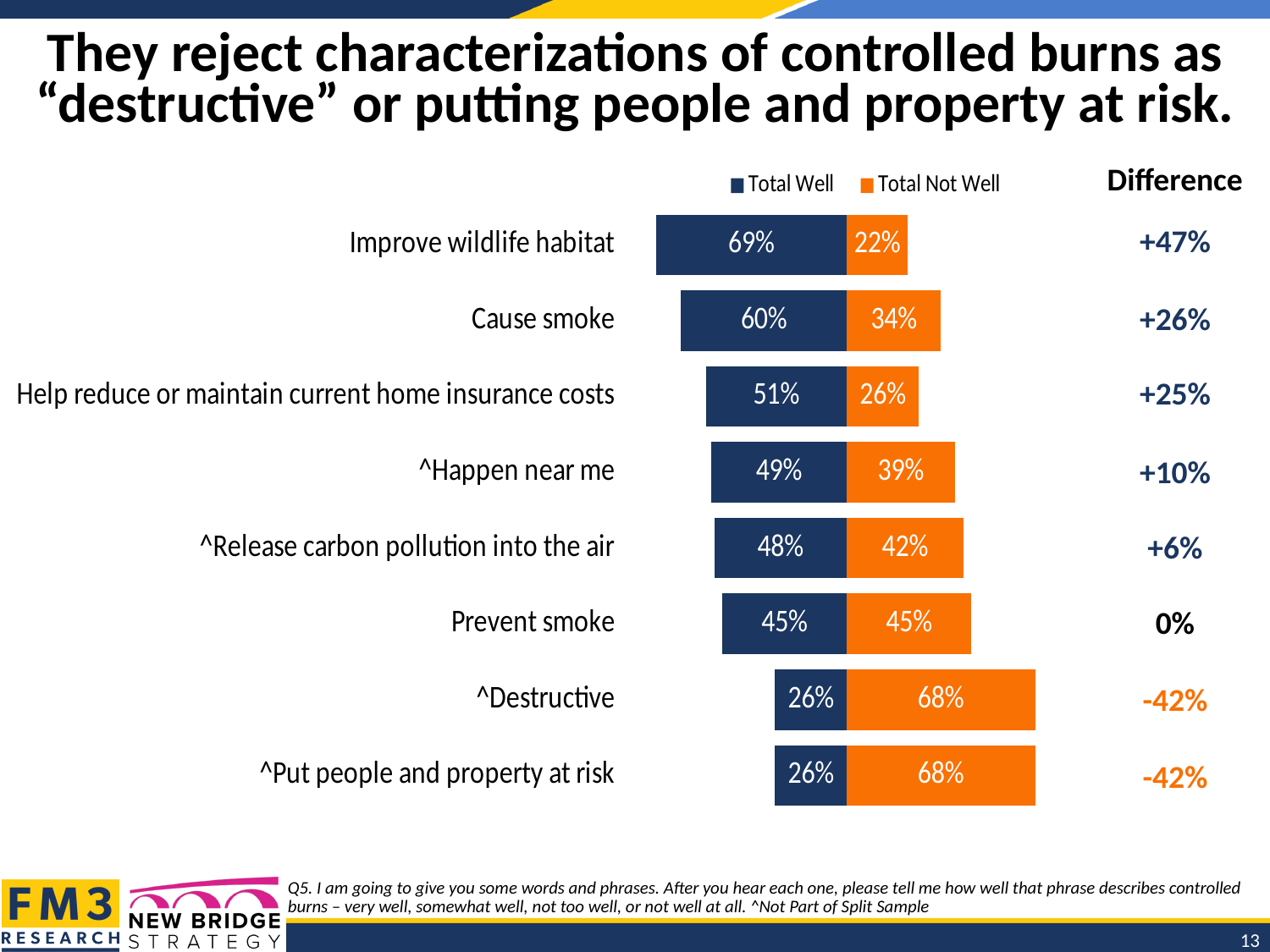
Which category has the lowest Total Not Well value? Improve wildlife habitat What colour represents the Total Not Well series? Orange Which is larger for "Destructive": Total Well or Total Not Well? Total Not Well What is the difference between the Total Well and Total Not Well values for "Happen near me"? +10% What is the total of the stacked bar for "Prevent smoke"? 90% Which category has the highest Total Well value? Improve wildlife habitat What is the Total Not Well value for "Cause smoke"? 34% How many categories are shown in the chart? 8 What is the Total Well value for "Improve wildlife habitat"? 69% What is the Total Well value for "Help reduce or maintain current home insurance costs"? 51% How many series does the legend list? 2 What kind of chart is shown on the slide? Bar chart